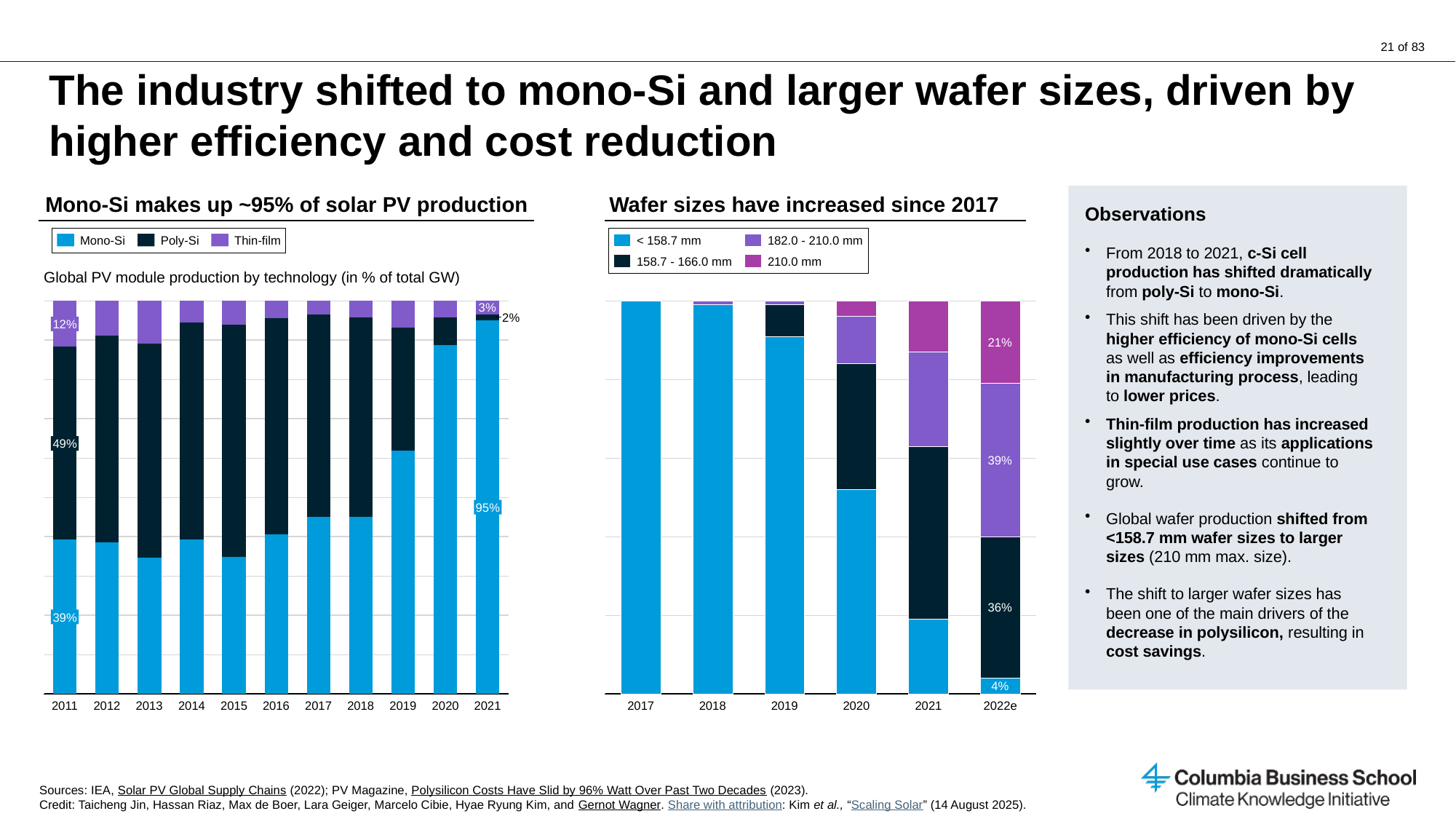
In the chart titled 'Mono-Si makes up ~95% of solar PV production', what was the Thin-film share in 2021? 3% In the chart titled 'Mono-Si makes up ~95% of solar PV production', does the Mono-Si share rise or fall from 2011 to 2021? rise In the chart titled 'Wafer sizes have increased since 2017', how many series does the legend list? 4 In the chart titled 'Mono-Si makes up ~95% of solar PV production', how many series does the legend list? 3 In the chart titled 'Mono-Si makes up ~95% of solar PV production', by how many percentage points did the Mono-Si share increase from 2011 to 2021? 56 percentage points In the chart titled 'Mono-Si makes up ~95% of solar PV production', what was the Mono-Si share in 2011? 39% In the chart titled 'Wafer sizes have increased since 2017', which wafer size category has the largest share in 2022e? 182.0 - 210.0 mm In the chart titled 'Mono-Si makes up ~95% of solar PV production', what was the Poly-Si share in 2011? 49% In the chart titled 'Mono-Si makes up ~95% of solar PV production', how many years are shown on the x axis? 11 In the chart titled 'Wafer sizes have increased since 2017', what is the share of 210.0 mm wafers in 2022e? 21% In the chart titled 'Mono-Si makes up ~95% of solar PV production', what was the Mono-Si share in 2021? 95% In the chart titled 'Wafer sizes have increased since 2017', what is the share of 158.7 - 166.0 mm wafers in 2022e? 36%